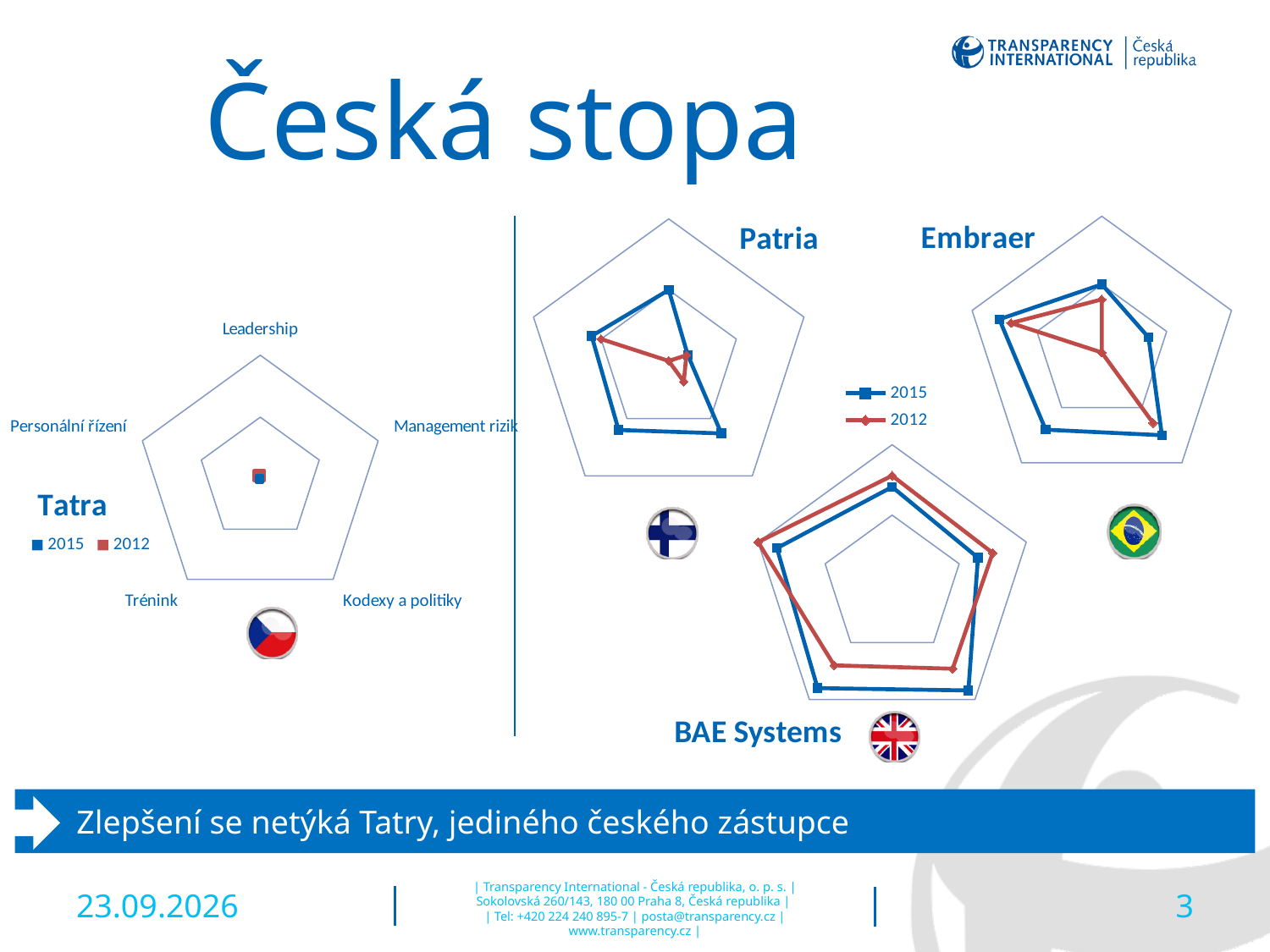
What colour is used for the 2015 series in the charts? blue How many categories (axes) does the Tatra radar chart have? 5 On the Embraer chart, which series extends further out on the top axis, 2015 or 2012? 2015 What are the two series named in the legend of the Tatra chart? 2015 and 2012 On the BAE Systems chart, which series extends further out on the top axis, 2015 or 2012? 2012 What kind of chart is the Tatra chart? radar chart How many series does the legend of the Tatra chart list? 2 Which company's chart shows both the 2015 and 2012 series collapsed at the centre of the pentagon? Tatra How many radar charts are shown on the slide? 4 On the Embraer chart, which series extends further out on the lower-left axis, 2015 or 2012? 2015